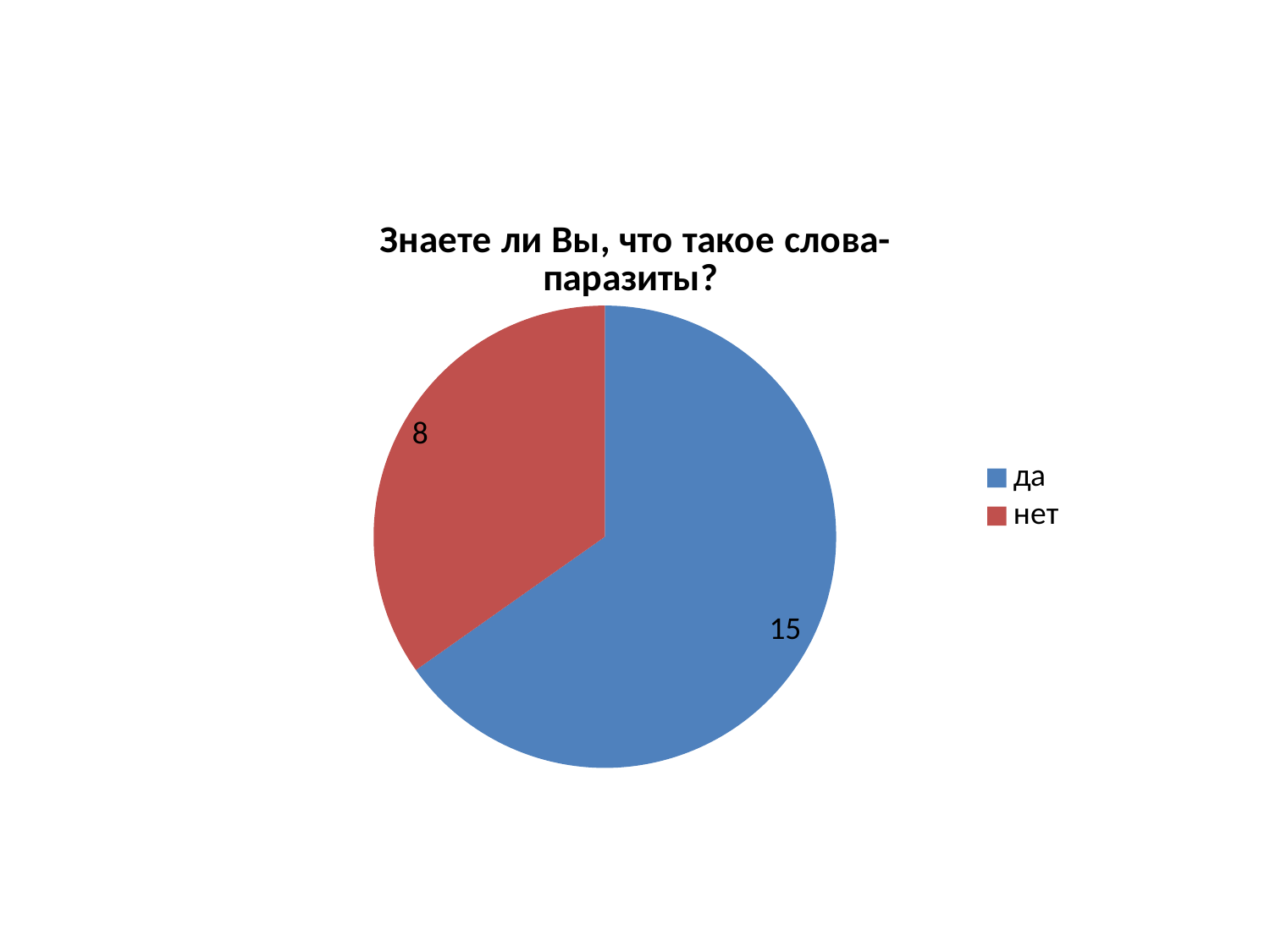
What is the value for "нет"? 8 What is the title of the chart? Знаете ли Вы, что такое слова-паразиты? What is the total of all slices in the pie chart? 23 What type of chart is shown on the slide? pie chart How many slices does the pie chart have? 2 What is the value for "да"? 15 Which category has the largest slice? да How many entries does the legend list? 2 What colour is the slice for "нет"? red Which category has the smallest slice? нет What is the difference between the values for "да" and "нет"? 7 Which is larger, the value for "да" or the value for "нет"? да